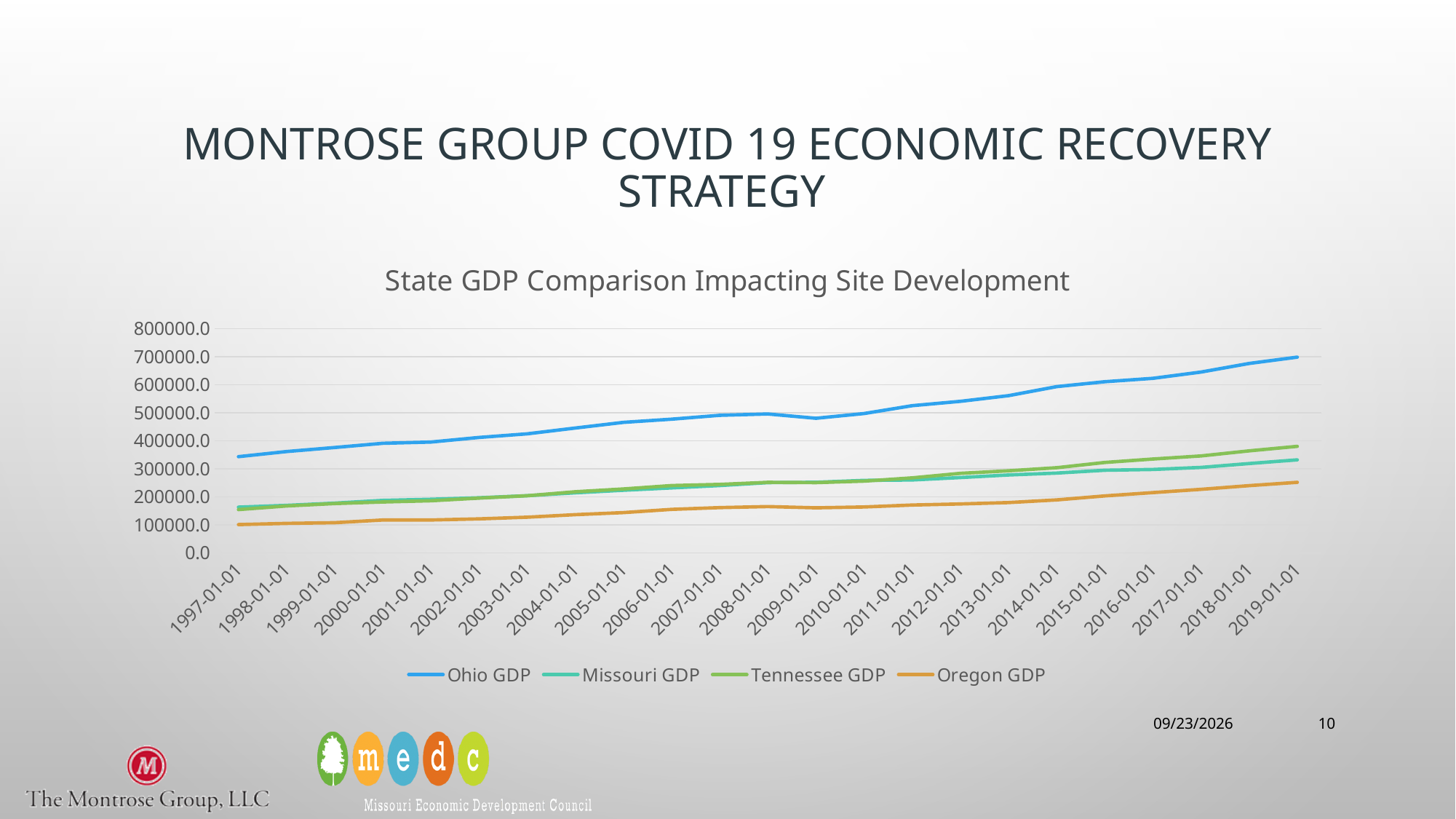
How many dates are shown along the x axis? 23 Which series is drawn in orange? Oregon GDP Is the value for Oregon GDP at 1997-01-01 greater or less than 200000.0? less How many series does the legend list? 4 At 2019-01-01, which is larger: Ohio GDP or Oregon GDP? Ohio GDP Which series has the highest value at 2019-01-01? Ohio GDP Is the value for Tennessee GDP at 2019-01-01 greater or less than 300000.0? greater What is the title of the chart? State GDP Comparison Impacting Site Development Does Ohio GDP generally rise or fall from 1997-01-01 to 2019-01-01? Rise What kind of chart is shown on the slide? Line chart Which series has the lowest value at 2019-01-01? Oregon GDP Is the value for Ohio GDP at 2019-01-01 greater or less than 600000.0? greater